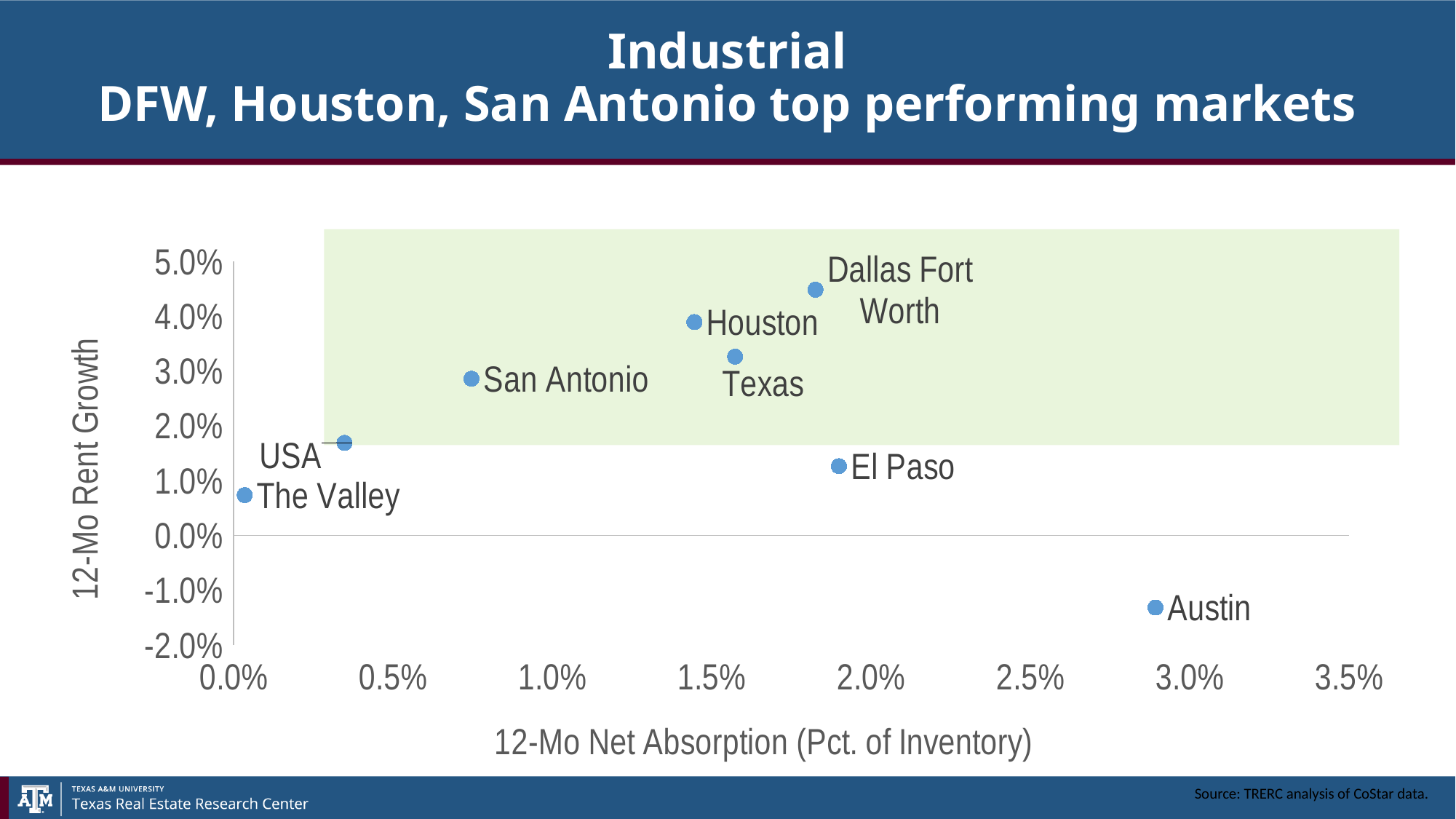
What kind of chart is shown on the slide? Scatter chart How many labeled markets (data points) are plotted on the chart? 8 Which has the higher 12-Mo Rent Growth, Houston or Texas? Houston What is the title of the horizontal axis? 12-Mo Net Absorption (Pct. of Inventory) Is the 12-Mo Rent Growth for Austin greater or less than 0.0%? less Is the 12-Mo Rent Growth for Dallas Fort Worth greater or less than 4.0%? greater Is the 12-Mo Net Absorption for Houston greater or less than 1.0%? greater Which market has the highest 12-Mo Rent Growth? Dallas Fort Worth Which market has the lowest 12-Mo Net Absorption (Pct. of Inventory)? The Valley Which market has the lowest 12-Mo Rent Growth? Austin Which has the higher 12-Mo Net Absorption, El Paso or San Antonio? El Paso Which market has the highest 12-Mo Net Absorption (Pct. of Inventory)? Austin